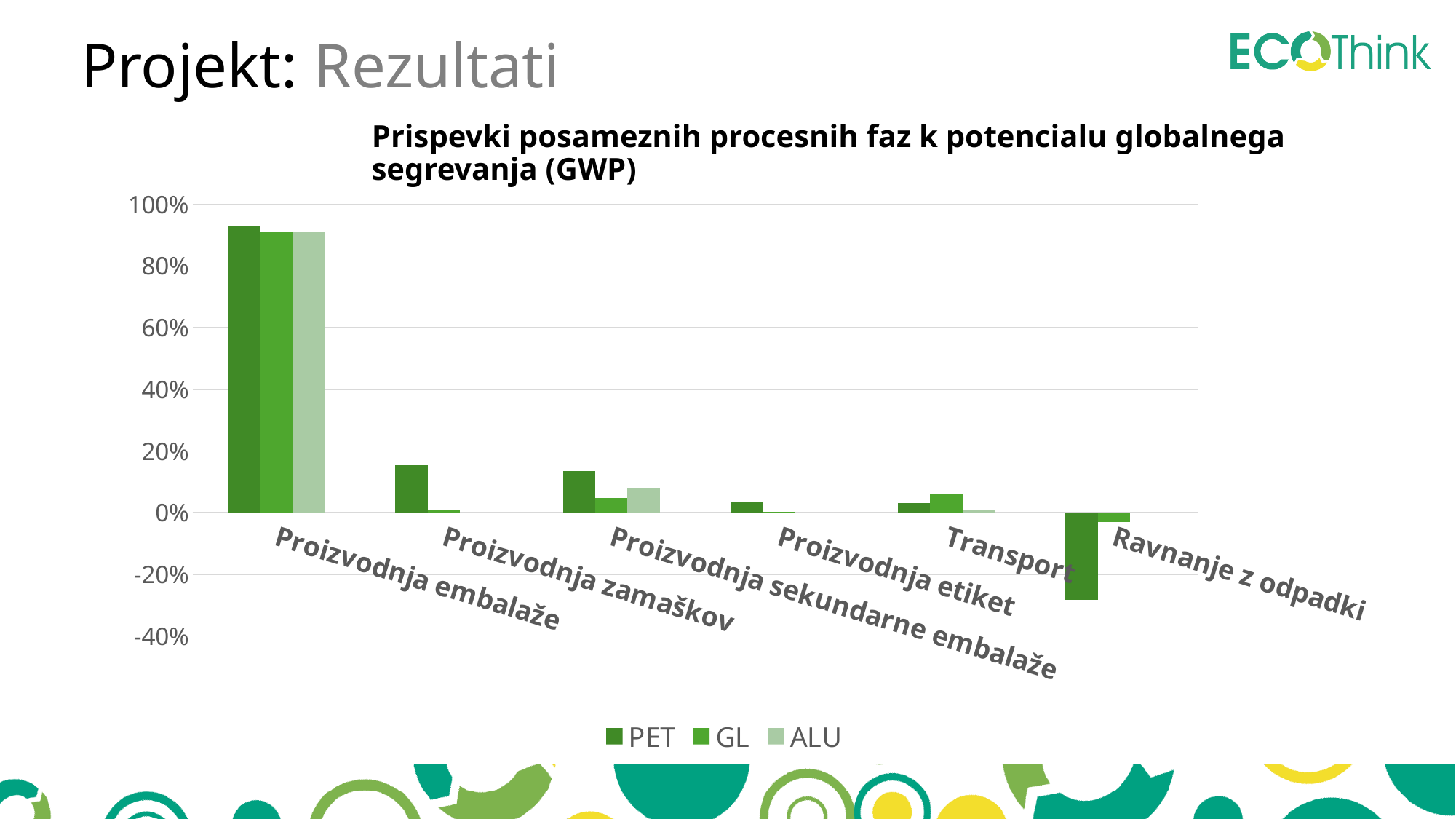
Which category has the highest PET value? Proizvodnja embalaže Which category has the lowest PET value? Ravnanje z odpadki How many series does the legend list? 3 Is the PET value for Ravnanje z odpadki greater or less than -20%? less For Proizvodnja sekundarne embalaže, which series has the larger value, PET or GL? PET Is the PET value for Proizvodnja zamaškov greater or less than 20%? less What are the three series listed in the legend? PET, GL, ALU For Transport, which series has the larger value, GL or PET? GL What is the title of the chart? Prispevki posameznih procesnih faz k potencialu globalnega segrevanja (GWP) Is the PET value for Proizvodnja embalaže greater or less than 80%? greater How many process-phase categories are shown on the x axis? 6 What kind of chart is shown on the slide? Bar chart